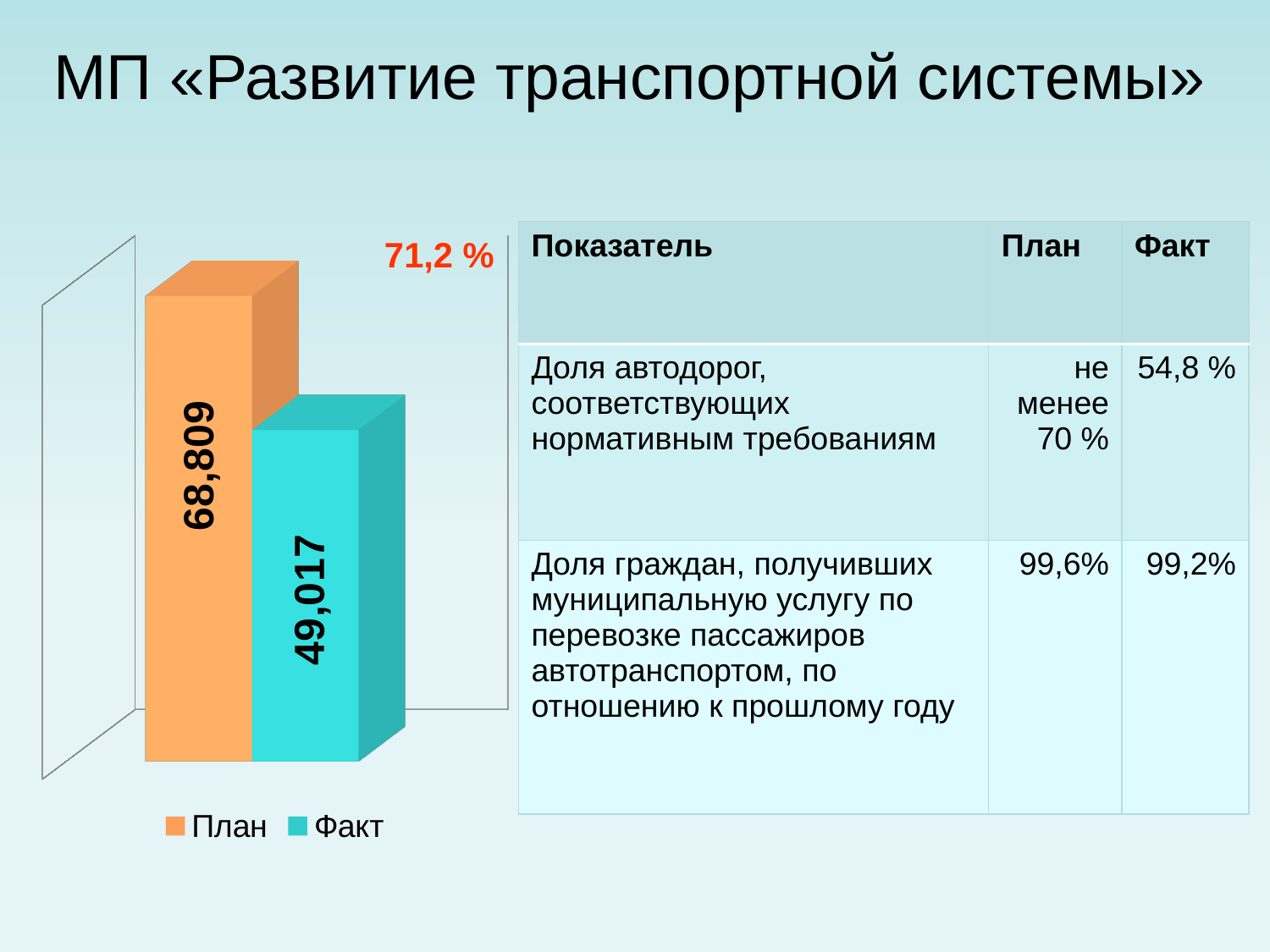
What kind of chart is shown on the slide? Bar chart How many series does the chart legend list? 2 Which bar in the chart is the highest? План What is the value of the Факт bar in the chart? 49,017 Which is larger in the chart, План or Факт? План Which bar in the chart is the lowest? Факт What is the value of the План bar in the chart? 68,809 What percentage is printed in red above the chart? 71,2 % How many bars are plotted in the chart? 2 What is the difference between the План and Факт values in the chart? 19,792 What colour is the Факт bar in the chart? Turquoise